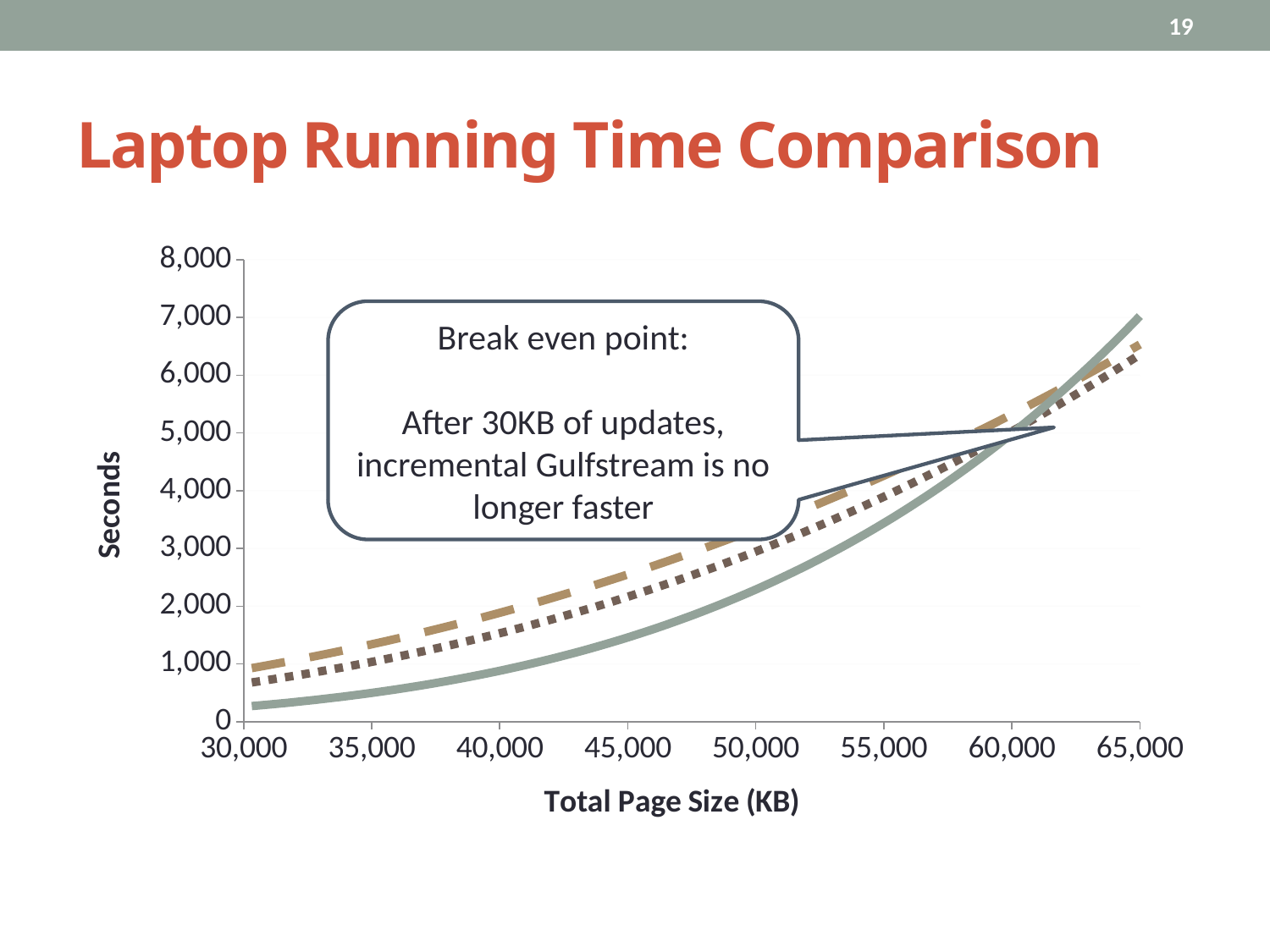
What kind of chart is shown on the slide? line chart At 65,000 KB, which line has the higher value, the solid line or the dotted line? the solid line Do the values of the solid line rise or fall as total page size increases? rise At 30,000 KB, which line has the higher value, the dashed line or the solid line? the dashed line What is the title of the chart's y axis? Seconds Is the value of the dashed line at 40,000 KB greater or less than 1,000 seconds? greater Is the value of the solid line at 30,000 KB greater or less than 1,000 seconds? less What is the title of the chart's x axis? Total Page Size (KB) Is the value of the dotted line at 30,000 KB greater or less than 1,000 seconds? less How many lines are plotted on the chart? 3 Which line has the lowest value at 30,000 KB? the solid line